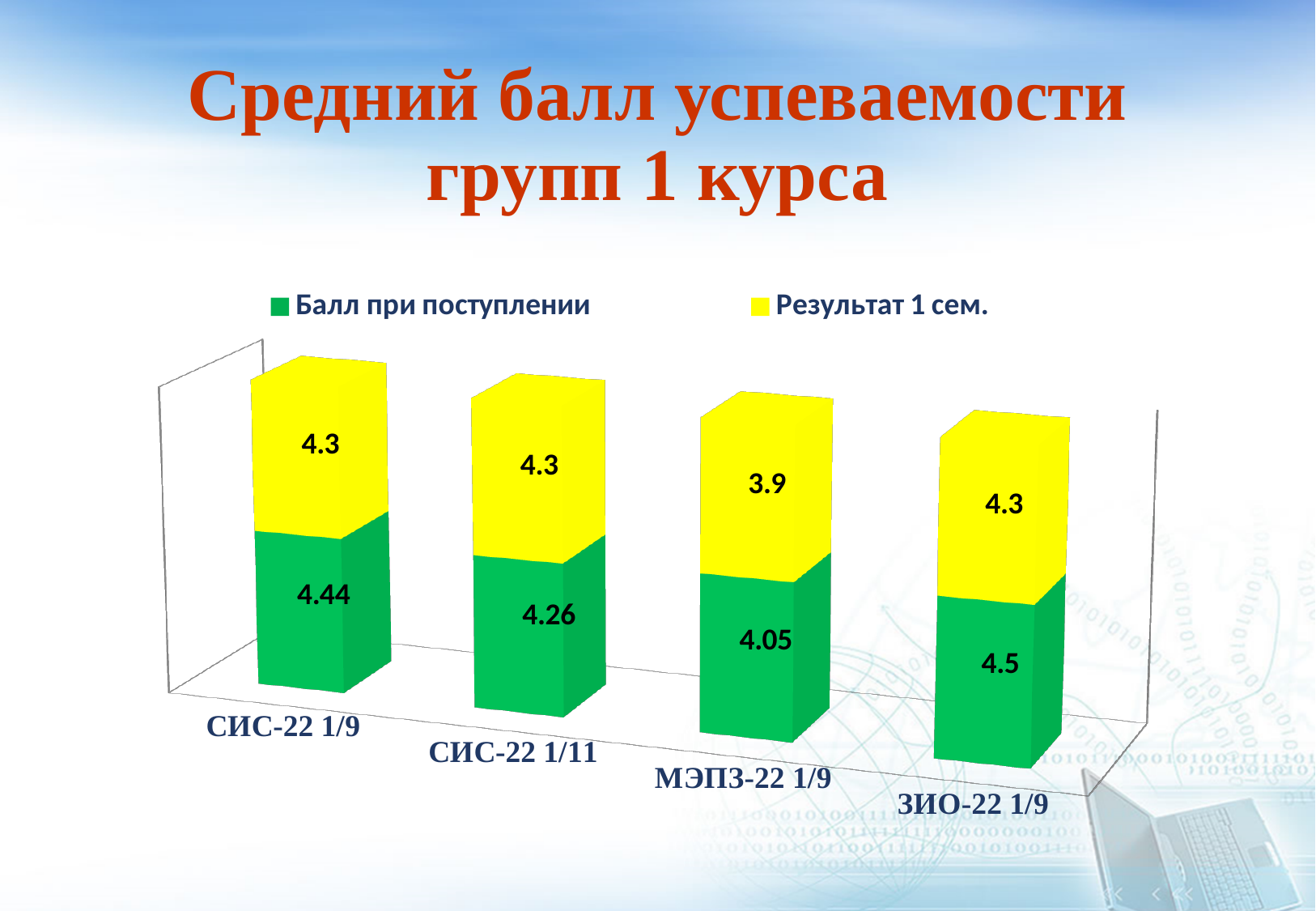
Which group has the highest value for "Балл при поступлении"? ЗИО-22 1/9 What is the value of "Балл при поступлении" for СИС-22 1/9? 4.44 What is the value of "Результат 1 сем." for СИС-22 1/11? 4.3 What is the difference between "Балл при поступлении" for ЗИО-22 1/9 and for МЭПЗ-22 1/9? 0.45 How many groups are shown on the x axis? 4 What is the value of "Балл при поступлении" for ЗИО-22 1/9? 4.5 How many series does the legend list? 2 What kind of chart is shown on the slide? Stacked bar chart Which group has the lowest value for "Результат 1 сем."? МЭПЗ-22 1/9 What is the total of the stacked bar for МЭПЗ-22 1/9? 7.95 What is the value of "Результат 1 сем." for МЭПЗ-22 1/9? 3.9 Which is larger for СИС-22 1/11: "Балл при поступлении" or "Результат 1 сем."? Результат 1 сем.